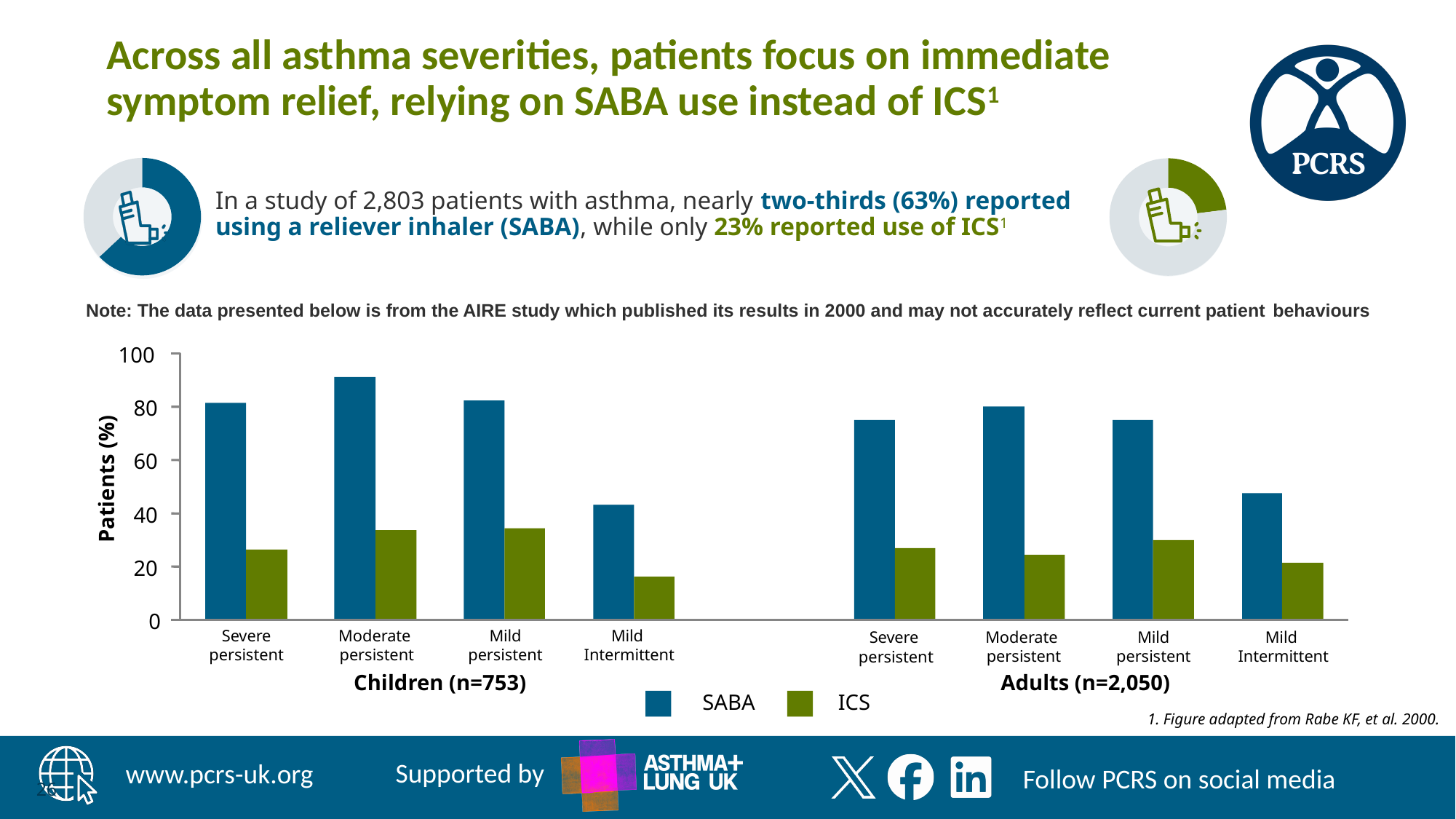
How many severity categories are plotted along the x axis in total (children and adults combined)? 8 Which is larger: the ICS value for Moderate persistent children or the ICS value for Moderate persistent adults? Moderate persistent children What is the label on the y axis of the chart? Patients (%) Which category has the lowest ICS bar? Mild Intermittent (Children) What kind of chart is shown on the slide? Bar chart Is the ICS value for Mild Intermittent children greater or less than 20? less Is the SABA value for Moderate persistent children greater or less than 80? greater How many series does the chart legend list? 2 Is the SABA value for Mild Intermittent adults greater or less than 60? less Which is larger: the SABA value for Severe persistent children or the SABA value for Severe persistent adults? Severe persistent children Which colour represents ICS in the chart legend? Green Which category has the highest SABA bar? Moderate persistent (Children)